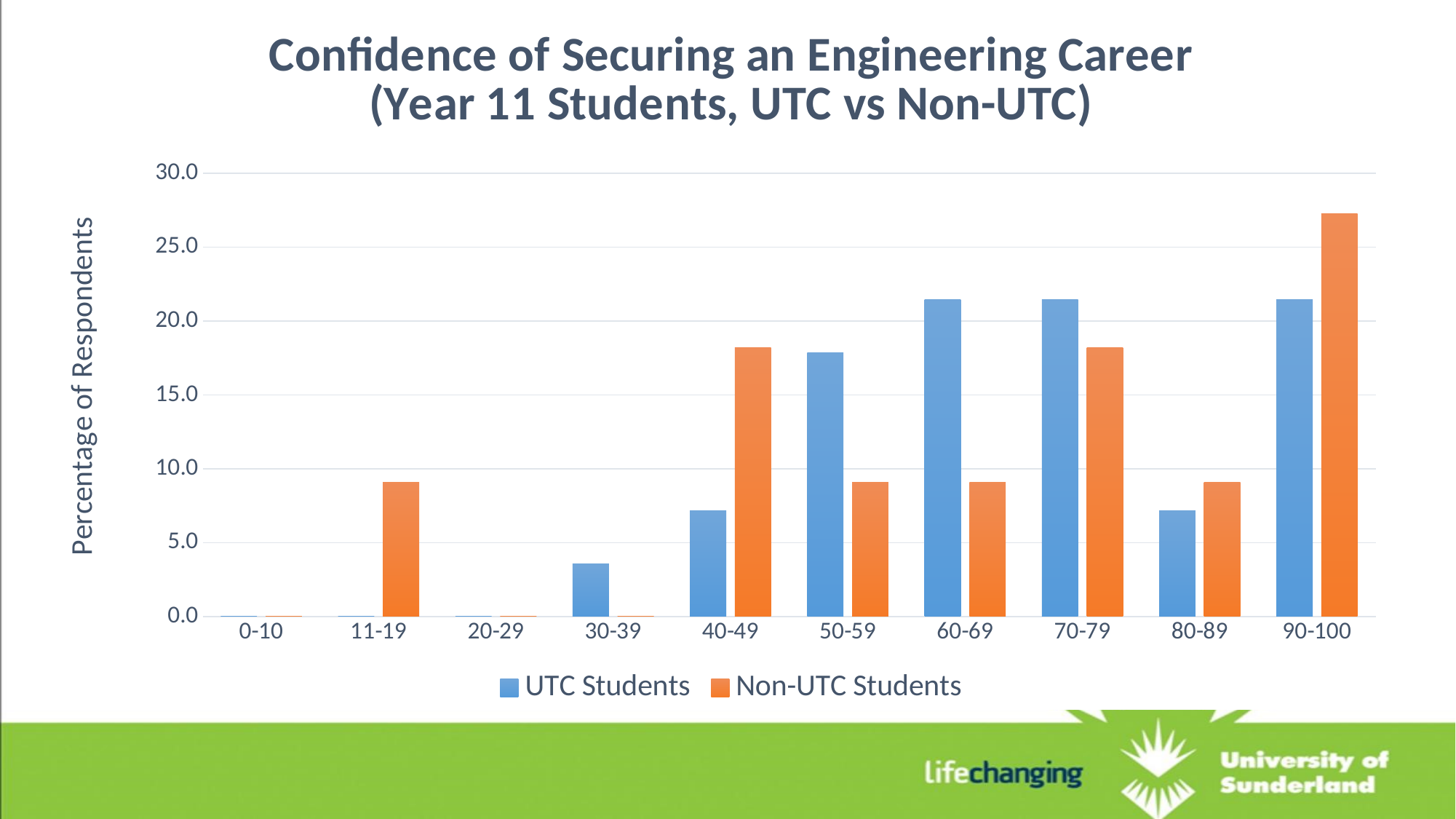
Is the value for UTC Students in the 30-39 category greater or less than 5.0? less Is the value for UTC Students in the 50-59 category greater or less than 15.0? greater Is the value for Non-UTC Students in the 90-100 category greater or less than 25.0? greater Which colour represents Non-UTC Students in the chart? orange In the 60-69 category, which series has the larger value, UTC Students or Non-UTC Students? UTC Students In the 40-49 category, which series has the larger value, UTC Students or Non-UTC Students? Non-UTC Students What kind of chart is shown on the slide? bar chart How many confidence categories are shown along the x axis? 10 How many series does the legend list? 2 What is the label of the y axis? Percentage of Respondents Which category has the highest value for Non-UTC Students? 90-100